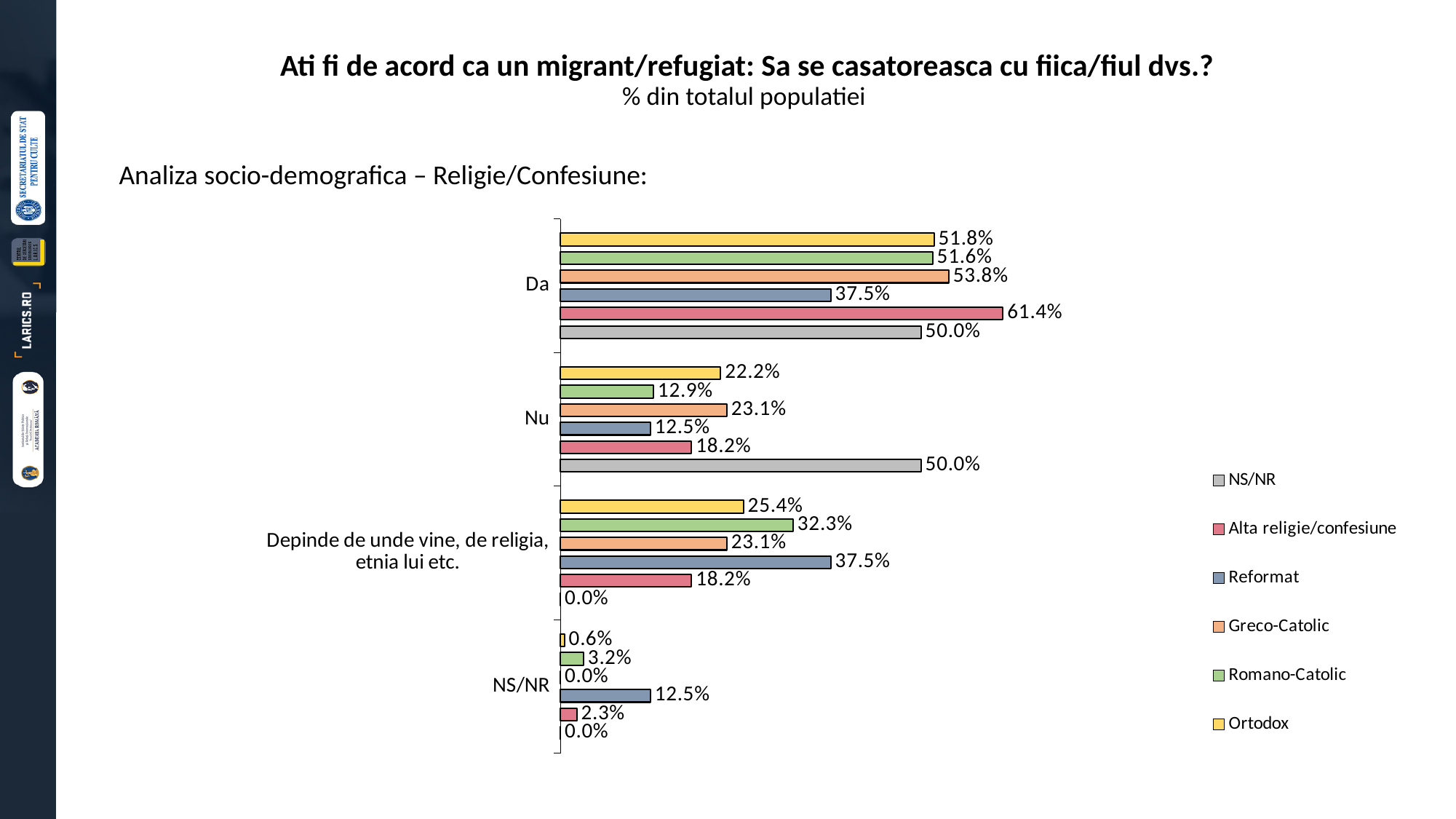
How many series does the legend list? 6 What is the value for Romano-Catolic in the 'Depinde de unde vine, de religia, etnia lui etc.' category? 32.3% What is the subtitle shown under the chart title? % din totalul populatiei Which series has the highest value in the 'Da' category? Alta religie/confesiune In the 'Nu' category, which is larger: the Greco-Catolic value or the Romano-Catolic value? Greco-Catolic What kind of chart is shown on the slide? bar chart How many response categories are shown on the vertical axis? 4 What is the difference between the Alta religie/confesiune value and the Reformat value in the 'Da' category? 23.9% What is the value for Reformat in the 'Nu' category? 12.5% Which series has the lowest value in the 'Da' category? Reformat Which series has the highest value in the 'NS/NR' category? Reformat What is the value for Ortodox in the 'Da' category? 51.8%